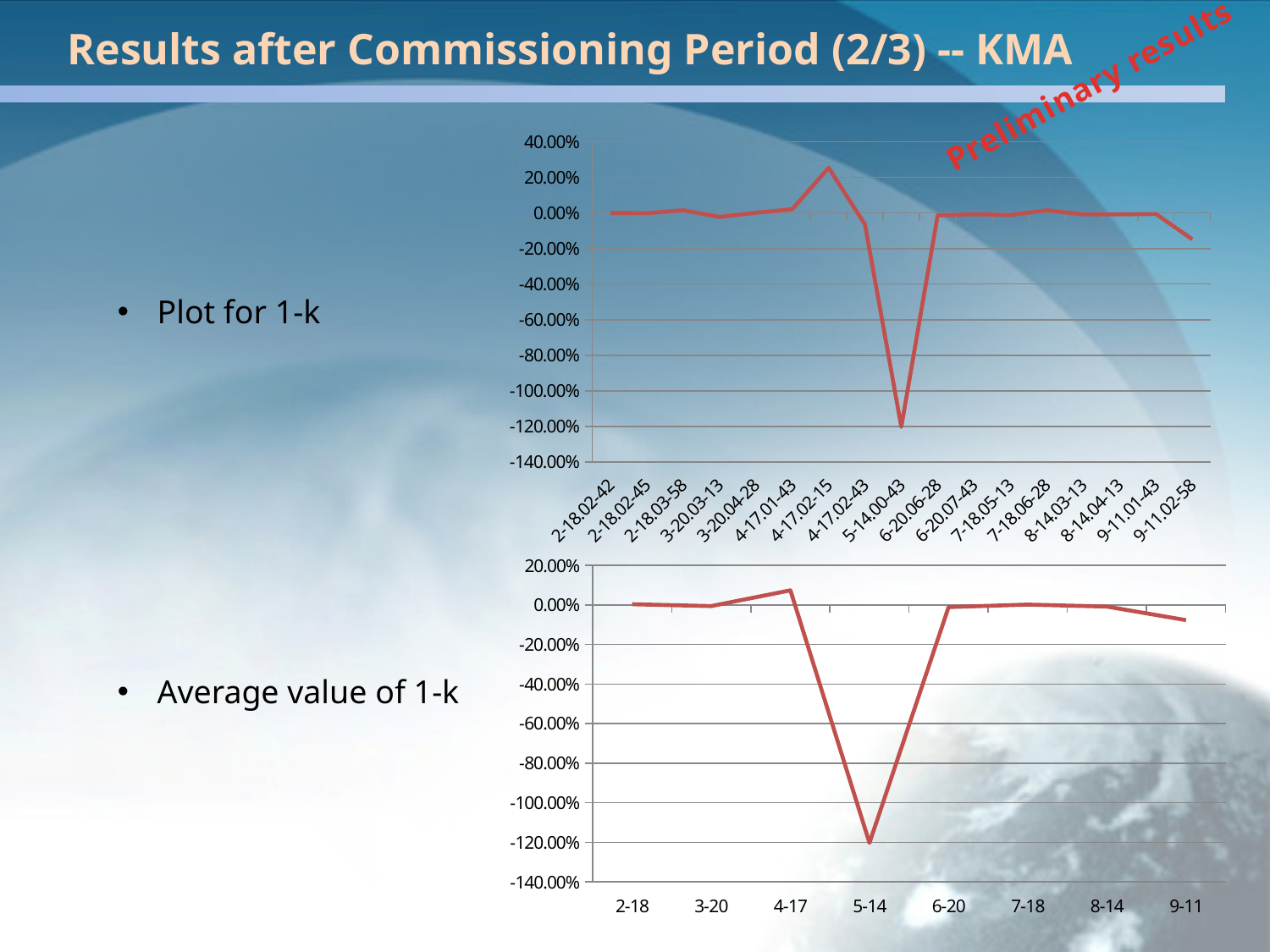
In the bottom chart (Average value of 1-k), how many categories are shown on the x axis? 8 What kind of chart is the top chart (Plot for 1-k)? line chart In the top chart (Plot for 1-k), which is larger, the value for 4-17.02-15 or the value for 9-11.02-58? 4-17.02-15 What is the highest value shown on the y axis of the top chart (Plot for 1-k)? 40.00% What kind of chart is the bottom chart (Average value of 1-k)? line chart In the top chart (Plot for 1-k), is the value for 4-17.02-15 greater or less than 0.00%? greater In the bottom chart (Average value of 1-k), is the value for 5-14 greater or less than -100.00%? less In the top chart (Plot for 1-k), which category has the highest value? 4-17.02-15 In the top chart (Plot for 1-k), which category has the lowest value? 5-14.00-43 In the bottom chart (Average value of 1-k), which category has the highest value? 4-17 In the bottom chart (Average value of 1-k), which category has the lowest value? 5-14 In the bottom chart (Average value of 1-k), which is larger, the value for 4-17 or the value for 5-14? 4-17